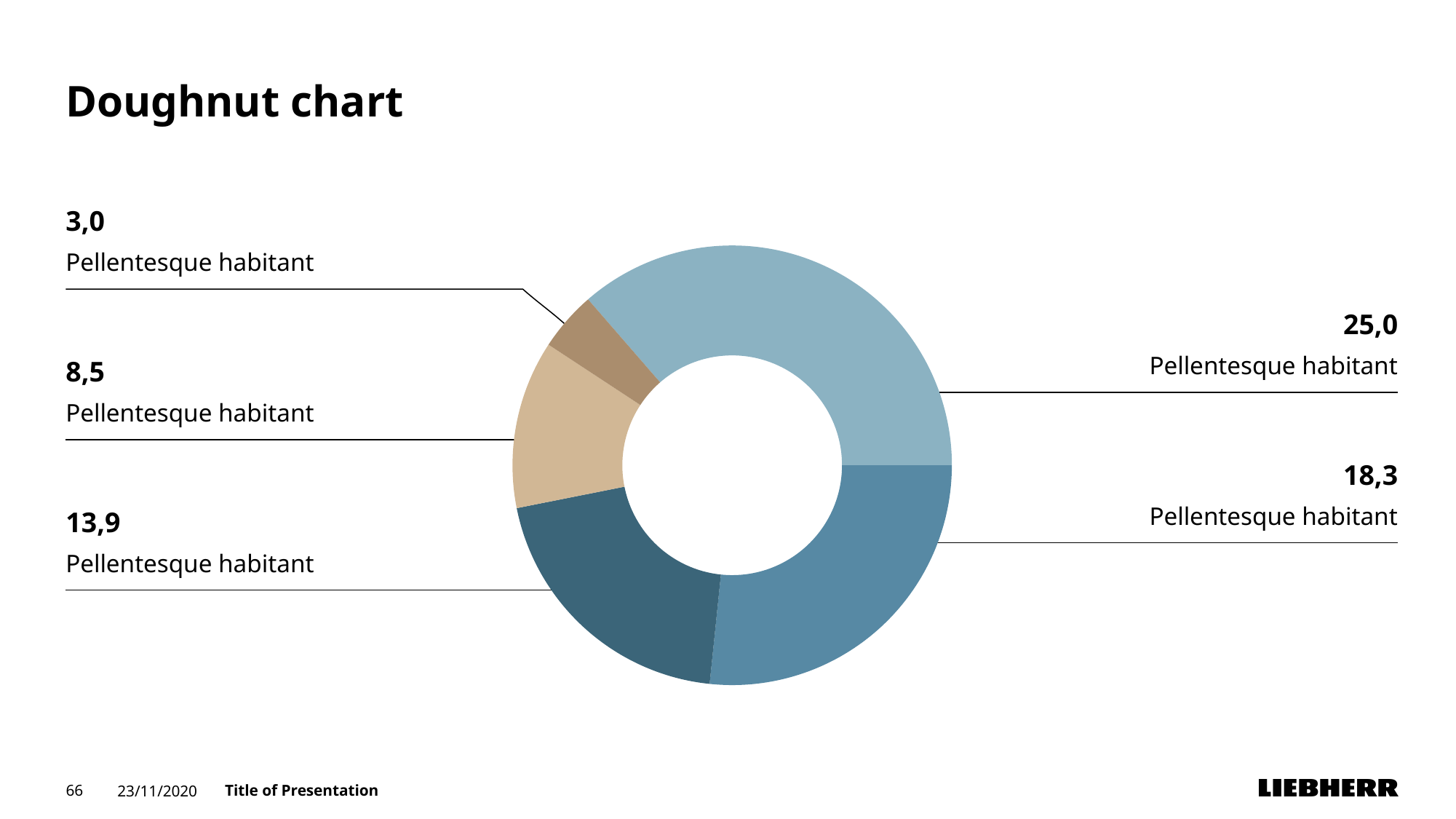
What is the largest value shown on the doughnut chart? 25,0 What is the smallest value shown on the doughnut chart? 3,0 What is the difference between the values 8,5 and 3,0 on the chart? 5,5 What is the title of the slide? Doughnut chart Which is larger, the slice labelled 18,3 or the slice labelled 13,9? 18,3 What kind of chart is shown on the slide? doughnut chart What is the difference between the values 13,9 and 8,5 on the chart? 5,4 How many slices does the doughnut chart have? 5 What is the total of all five values shown on the doughnut chart? 68,7 What value is shown for the dark blue slice at the bottom left of the doughnut? 13,9 What is the difference between the two largest values on the chart, 25,0 and 18,3? 6,7 What value is shown for the light blue slice at the top right of the doughnut? 25,0